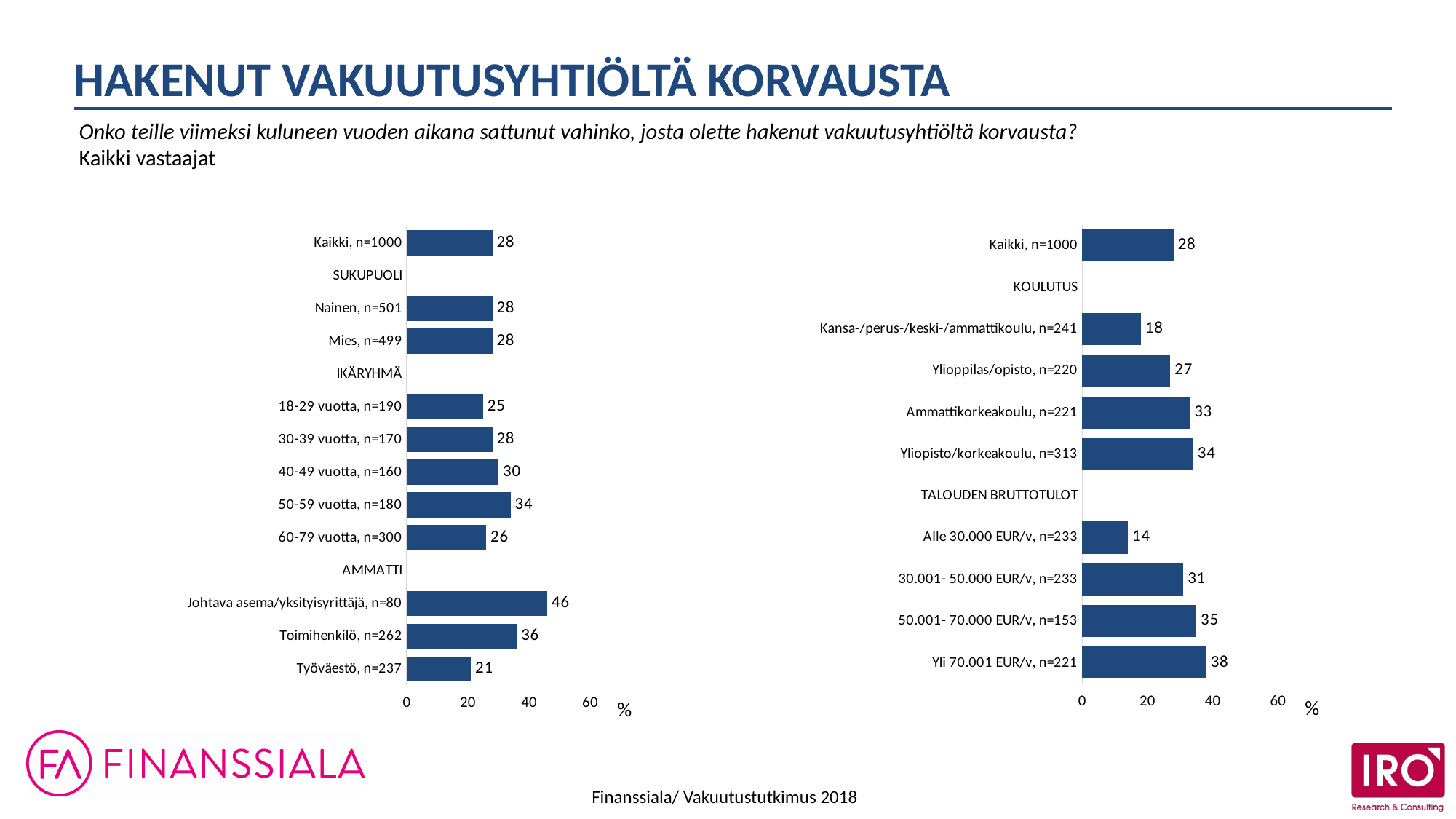
In the right chart, is the value for 50.001- 70.000 EUR/v, n=153 greater or less than 20? greater In the left chart, which is larger: the value for 50-59 vuotta, n=180 or 60-79 vuotta, n=300? 50-59 vuotta, n=180 What kind of chart is shown on the left of the slide? bar chart In the left chart, what is the difference between the values for Toimihenkilö, n=262 and Työväestö, n=237? 15 In the left chart, which category has the lowest value? Työväestö, n=237 In the left chart, which category has the highest value? Johtava asema/yksityisyrittäjä, n=80 In the right chart, which category has the highest value? Yli 70.001 EUR/v, n=221 In the right chart, what is the difference between the values for Yliopisto/korkeakoulu, n=313 and Kansa-/perus-/keski-/ammattikoulu, n=241? 16 In the right chart, what is the value for Alle 30.000 EUR/v, n=233? 14 In the right chart, what is the value for Kaikki, n=1000? 28 In the right chart, which category has the lowest value? Alle 30.000 EUR/v, n=233 In the left chart, what is the value for Johtava asema/yksityisyrittäjä, n=80? 46